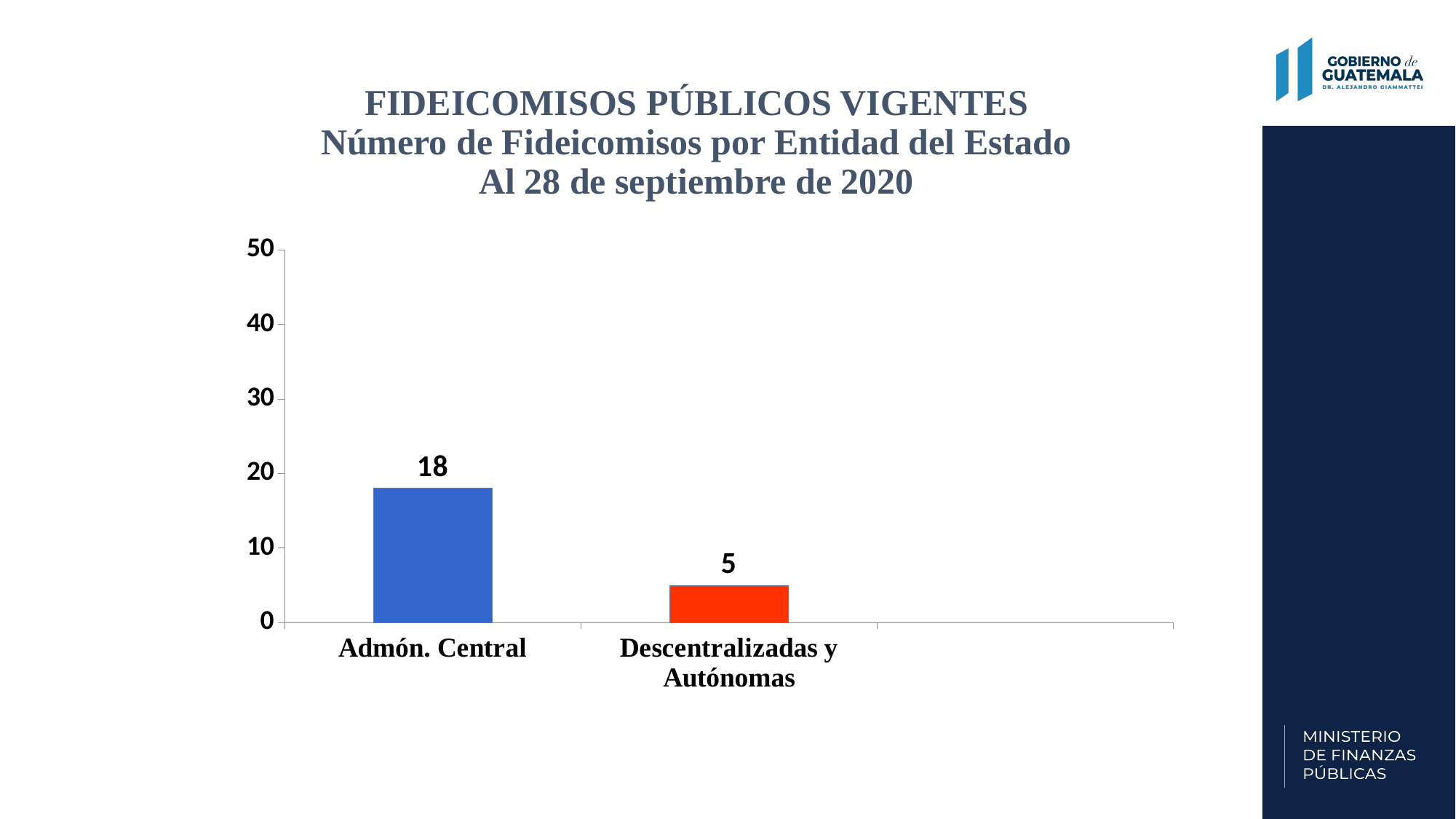
What is the value for Descentralizadas y Autónomas? 5 Is the value for Admón. Central greater or less than 20? less What is the highest value shown on the vertical axis? 50 Which is larger, the value for Admón. Central or the value for Descentralizadas y Autónomas? Admón. Central What is the total of the two values shown on the chart? 23 What kind of chart is shown on the slide? Bar chart Which category has the highest value? Admón. Central Which category has the lowest value? Descentralizadas y Autónomas What is the value for Admón. Central? 18 Is the value for Descentralizadas y Autónomas greater or less than 10? less How many categories are shown on the chart? 2 What is the difference between the values for Admón. Central and Descentralizadas y Autónomas? 13